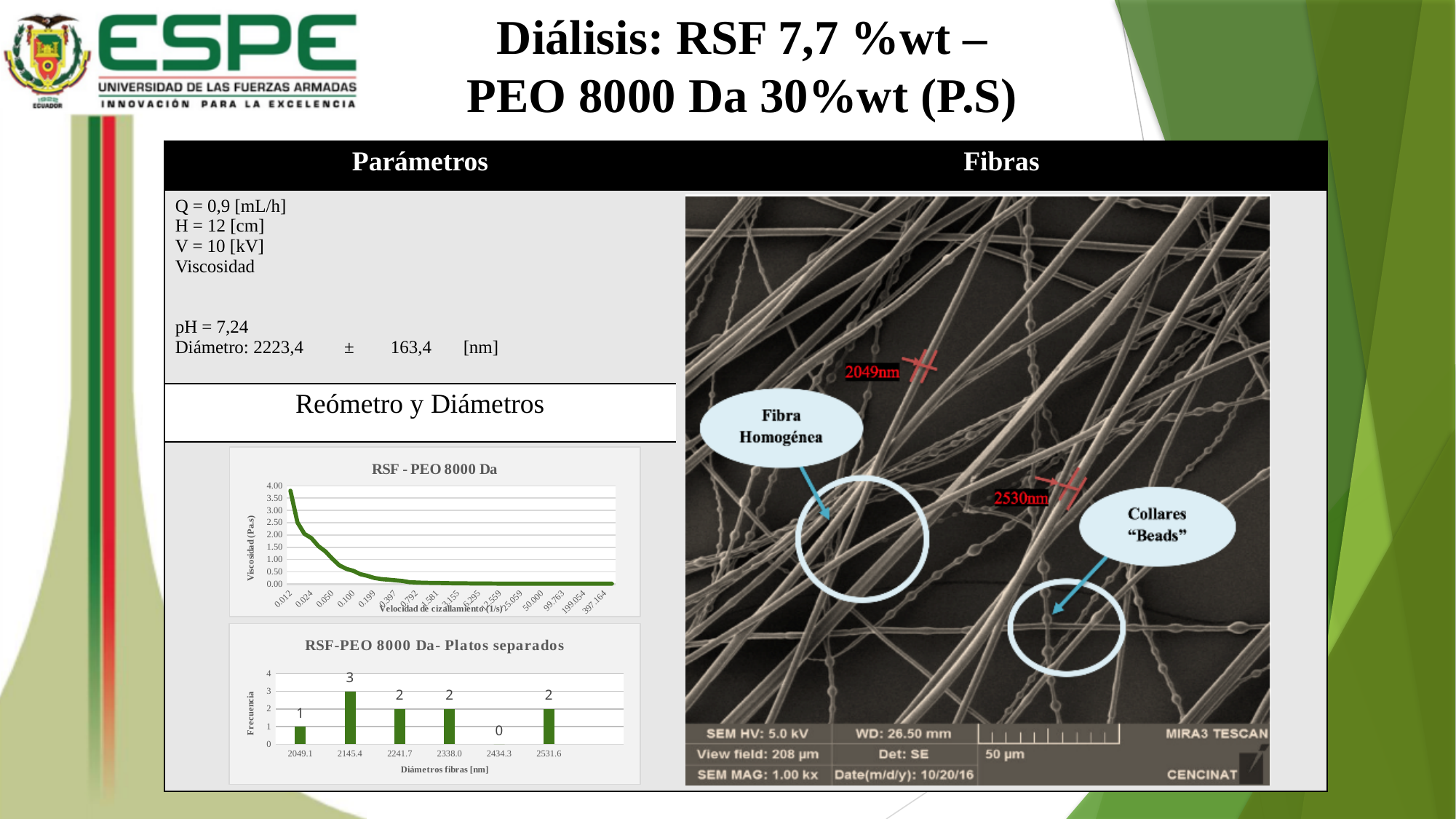
In the chart titled "RSF - PEO 8000 Da", does the viscosity rise or fall as the shear rate increases along the x axis? fall In the chart titled "RSF-PEO 8000 Da- Platos separados", what is the difference between the frequency for 2145.4 nm and the frequency for 2049.1 nm? 2 In the chart titled "RSF-PEO 8000 Da- Platos separados", what is the frequency for the diameter 2434.3 nm? 0 What kind of chart is the one titled "RSF - PEO 8000 Da"? line chart In the chart titled "RSF-PEO 8000 Da- Platos separados", which has a larger frequency, 2241.7 nm or 2049.1 nm? 2241.7 In the chart titled "RSF-PEO 8000 Da- Platos separados", what is the frequency for the diameter 2145.4 nm? 3 In the chart titled "RSF-PEO 8000 Da- Platos separados", what is the frequency for the diameter 2049.1 nm? 1 In the chart titled "RSF-PEO 8000 Da- Platos separados", which diameter category has the highest frequency? 2145.4 In the chart titled "RSF-PEO 8000 Da- Platos separados", which diameter category has the lowest frequency? 2434.3 In the chart titled "RSF - PEO 8000 Da", is the viscosity at a shear rate of 0.012 greater or less than 3.00? greater What kind of chart is the one titled "RSF-PEO 8000 Da- Platos separados"? bar chart How many diameter categories are shown in the chart titled "RSF-PEO 8000 Da- Platos separados"? 6